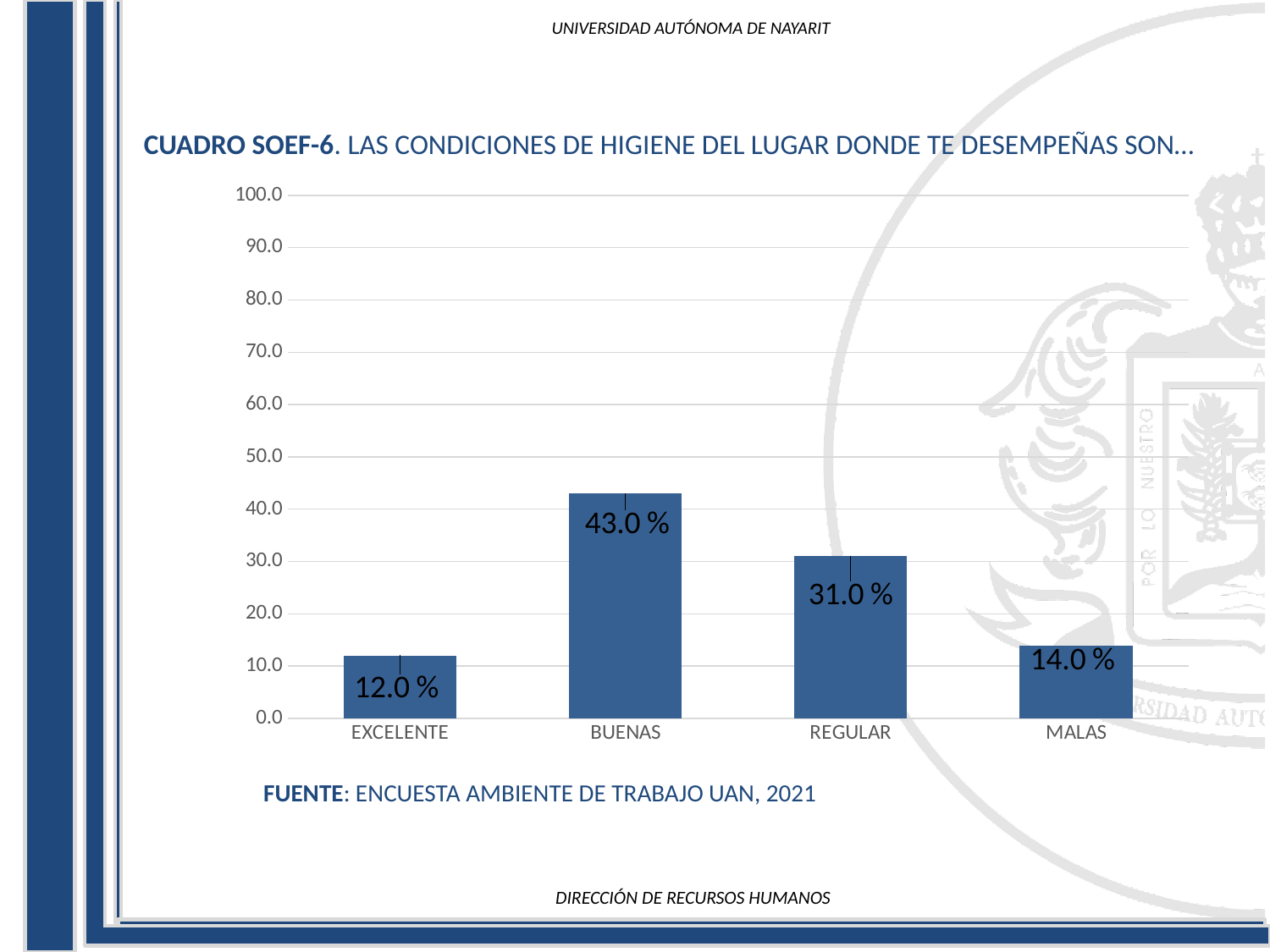
Which is larger, the value for MALAS or the value for EXCELENTE? MALAS Which category has the highest value? BUENAS What is the value for REGULAR? 31.0 % Which category has the lowest value? EXCELENTE How many categories are shown on the x axis? 4 What is the difference between the values for BUENAS and REGULAR? 12.0 % What is the value for EXCELENTE? 12.0 % What kind of chart is shown on the slide? bar chart What is the value for BUENAS? 43.0 % Is the value for REGULAR greater or less than 40.0? less What is the value for MALAS? 14.0 % What source is cited below the chart? ENCUESTA AMBIENTE DE TRABAJO UAN, 2021